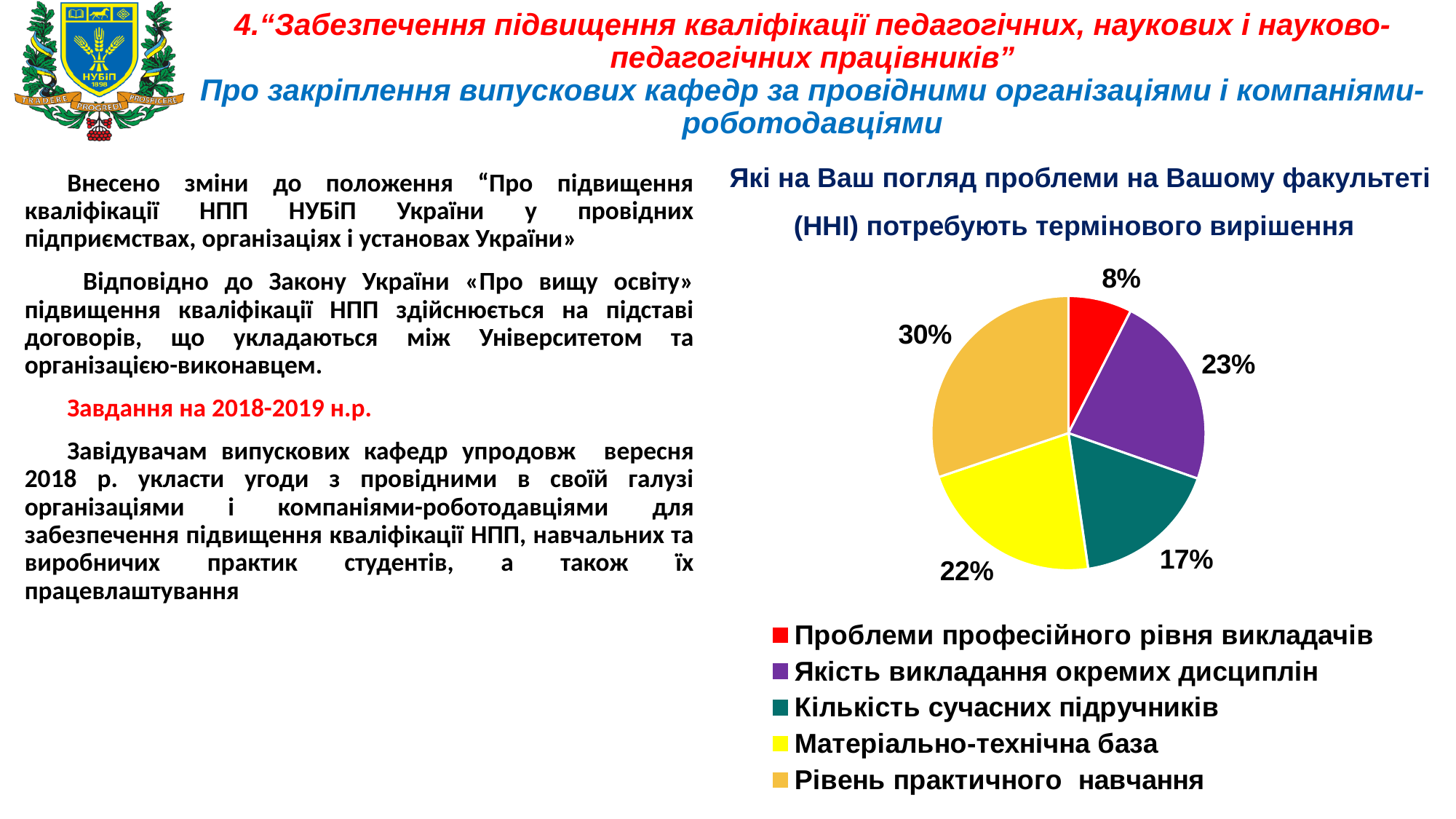
Which is larger: the slice for "Якість викладання окремих дисциплін" or the slice for "Проблеми професійного рівня викладачів"? Якість викладання окремих дисциплін How many categories does the pie chart have? 5 What share of the pie does "Рівень практичного навчання" have? 30% What kind of chart is shown on the slide? pie chart What share of the pie does "Проблеми професійного рівня викладачів" have? 8% Which category has the largest slice of the pie? Рівень практичного навчання What colour is the slice for "Матеріально-технічна база"? yellow Which category has the smallest slice of the pie? Проблеми професійного рівня викладачів What share of the pie does "Якість викладання окремих дисциплін" have? 23% What is the difference in percentage points between "Рівень практичного навчання" and "Кількість сучасних підручників"? 13